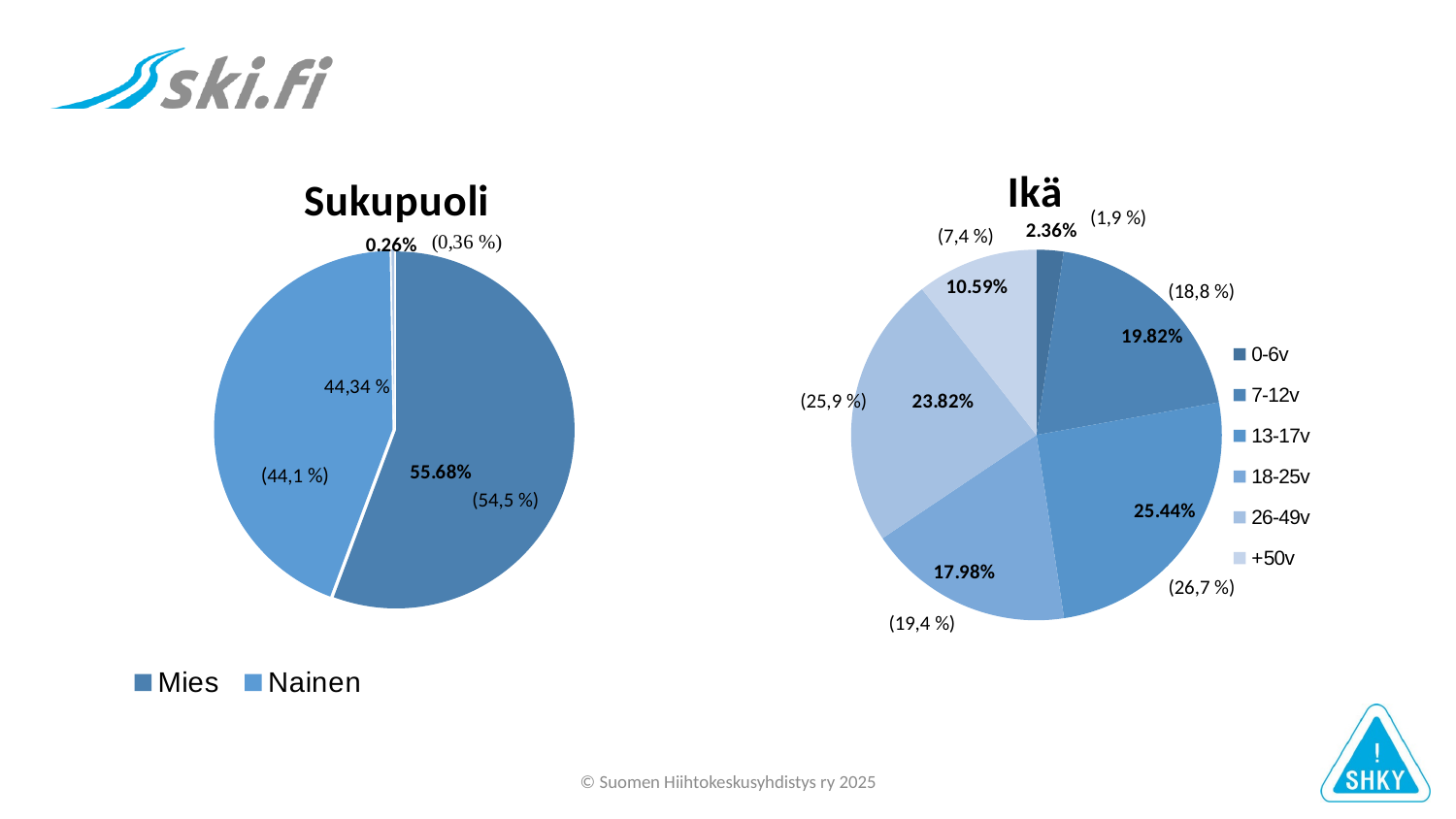
In the Sukupuoli chart, which is larger, Mies or Nainen? Mies In the Ikä chart, what percentage is shown for 13-17v? 25.44% What kind of chart is the Sukupuoli chart? Pie chart In the Ikä chart, which is larger, 7-12v or 18-25v? 7-12v How many entries does the legend of the Sukupuoli chart list? 2 In the Ikä chart, what percentage is shown for 0-6v? 2.36% In the Sukupuoli chart, what percentage is shown for Mies? 55.68% How many age groups does the legend of the Ikä chart list? 6 In the Ikä chart, which age group has the largest share? 13-17v In the Sukupuoli chart, what is the difference between the Mies and Nainen percentages? 11.34% In the Sukupuoli chart, what percentage is shown for Nainen? 44,34 % In the Ikä chart, which age group has the smallest share? 0-6v